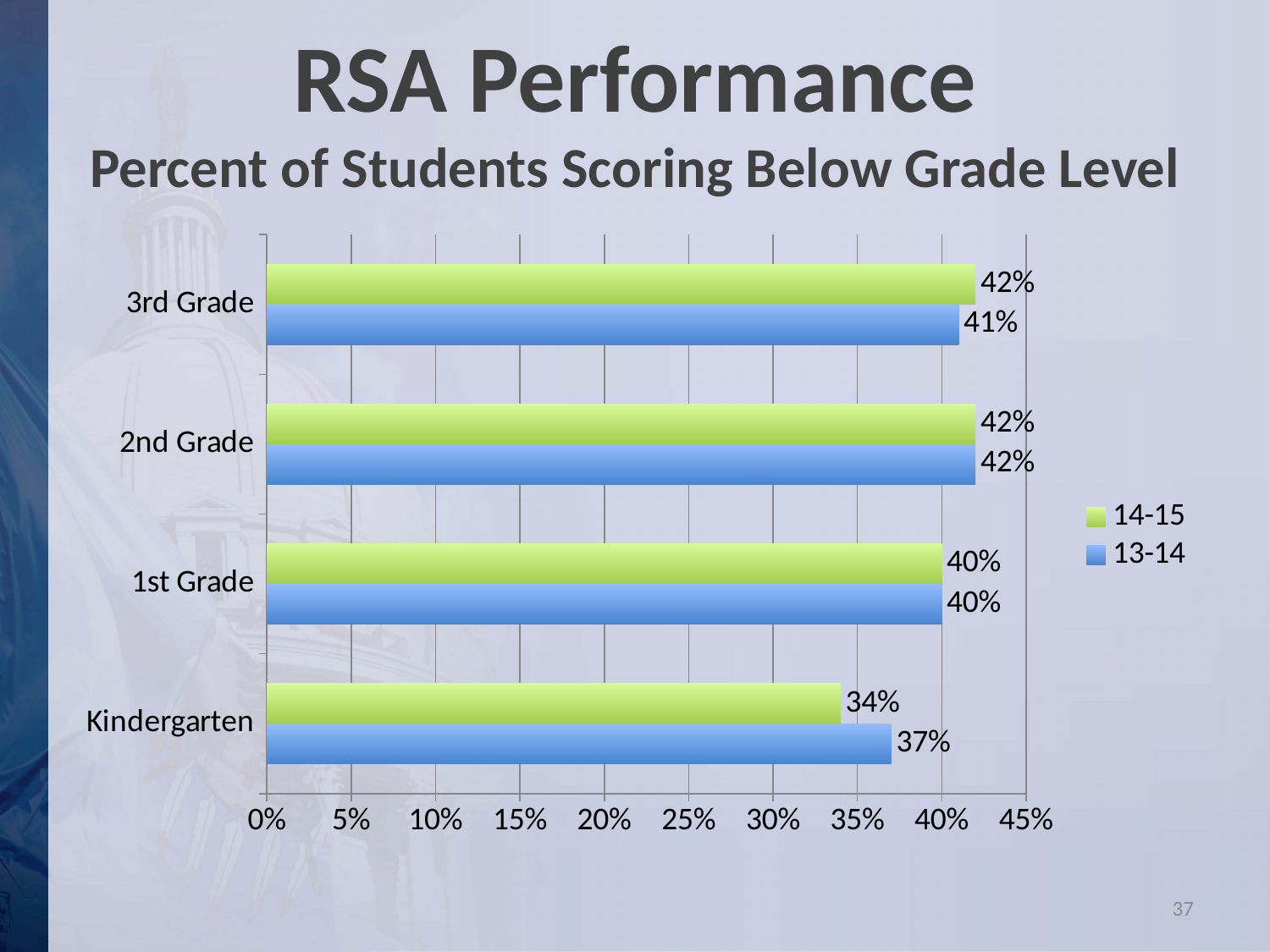
What is the difference between the 13-14 and 14-15 values for Kindergarten? 3% Which grade has the lowest 14-15 value? Kindergarten What percent of 3rd Grade students scored below grade level in 14-15? 42% Which grade has the lowest 13-14 value? Kindergarten How many series does the legend list? 2 What percent of Kindergarten students scored below grade level in 13-14? 37% What kind of chart is shown on the slide? Bar chart What is the difference between the 14-15 and 13-14 values for 3rd Grade? 1% For Kindergarten, which series has the larger value, 13-14 or 14-15? 13-14 What is the 13-14 value for 1st Grade? 40% How many grade levels are shown on the chart? 4 Which colour represents the 14-15 series? Green